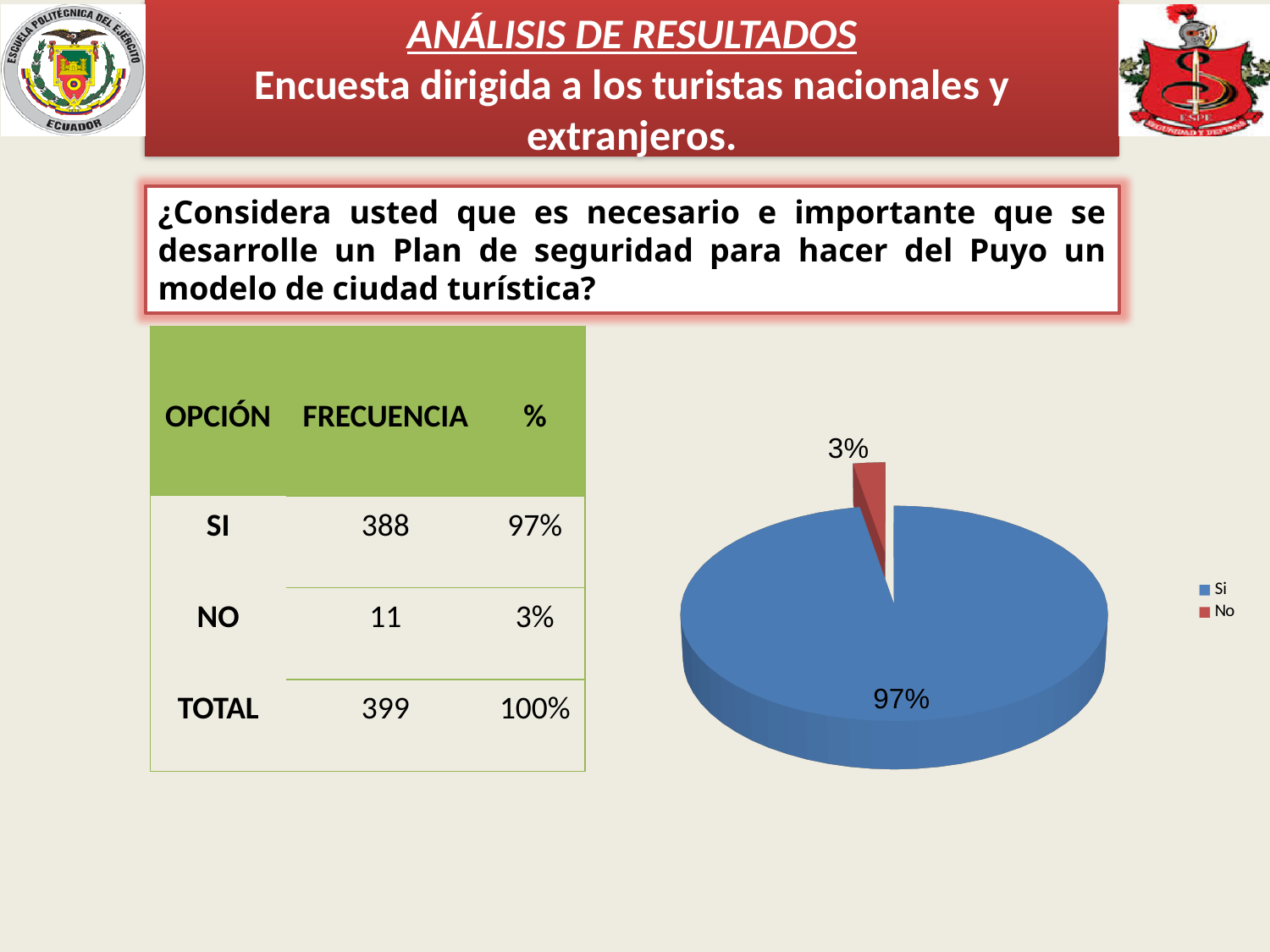
Which is larger, the Si slice or the No slice? Si What share of the pie does the Si slice represent? 97% Which slice of the pie is the smallest? No How many slices does the pie chart have? 2 What colour is the Si slice in the pie chart? blue What kind of chart is shown on the slide? pie chart What colour is the No slice in the pie chart? red How many entries does the legend list? 2 Which slice of the pie is the largest? Si What is the difference in percentage points between the Si slice and the No slice? 94 What share of the pie does the No slice represent? 3%